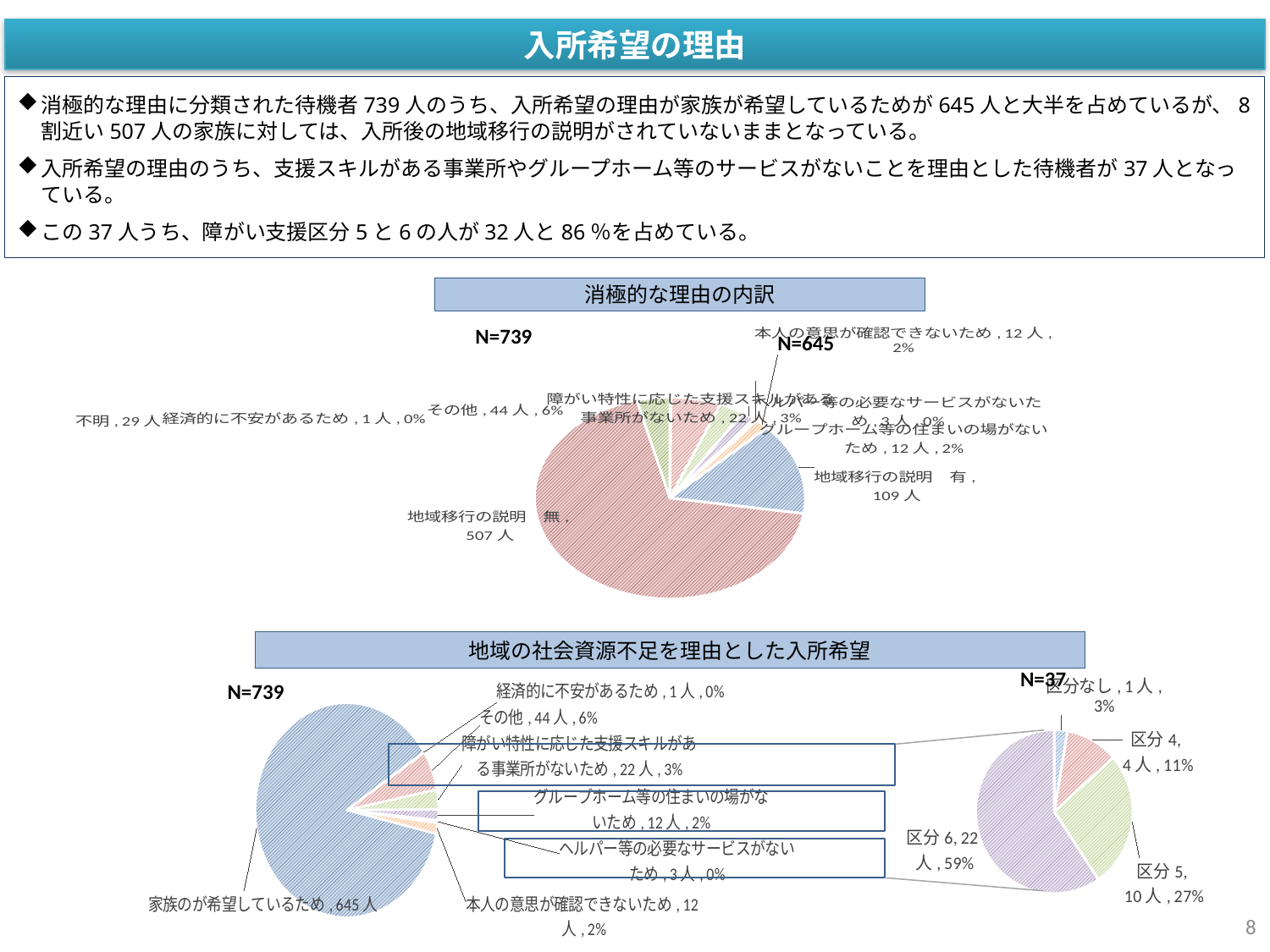
In the right-hand pie (N=37) of the chart titled 地域の社会資源不足を理由とした入所希望, what share of the pie is 区分 5? 27% In the right-hand pie (N=37) of the chart titled 地域の社会資源不足を理由とした入所希望, how many people are in 区分 6? 22 人 In the chart titled 消極的な理由の内訳, which is larger: 地域移行の説明 有 or 地域移行の説明 無? 地域移行の説明 無 In the chart titled 消極的な理由の内訳, what is the difference in people between 地域移行の説明 無 (507 人) and 地域移行の説明 有 (109 人)? 398 人 In the right-hand pie (N=37) of the chart titled 地域の社会資源不足を理由とした入所希望, which category has the largest slice? 区分 6 In the left-hand pie (N=739) of the chart titled 地域の社会資源不足を理由とした入所希望, what share of the pie is その他? 6% In the chart titled 消極的な理由の内訳, how many people are in the category 地域移行の説明 無? 507 人 In the right-hand pie (N=37) of the chart titled 地域の社会資源不足を理由とした入所希望, what is the difference in people between 区分 6 and 区分 5? 12 人 In the chart titled 地域の社会資源不足を理由とした入所希望, what kind of chart is the right-hand chart (N=37)? pie chart In the right-hand pie (N=37) of the chart titled 地域の社会資源不足を理由とした入所希望, which category has the smallest slice? 区分なし In the left-hand pie (N=739) of the chart titled 地域の社会資源不足を理由とした入所希望, how many people are in the category 家族のが希望しているため? 645 人 In the right-hand pie (N=37) of the chart titled 地域の社会資源不足を理由とした入所希望, how many slices are there? 4